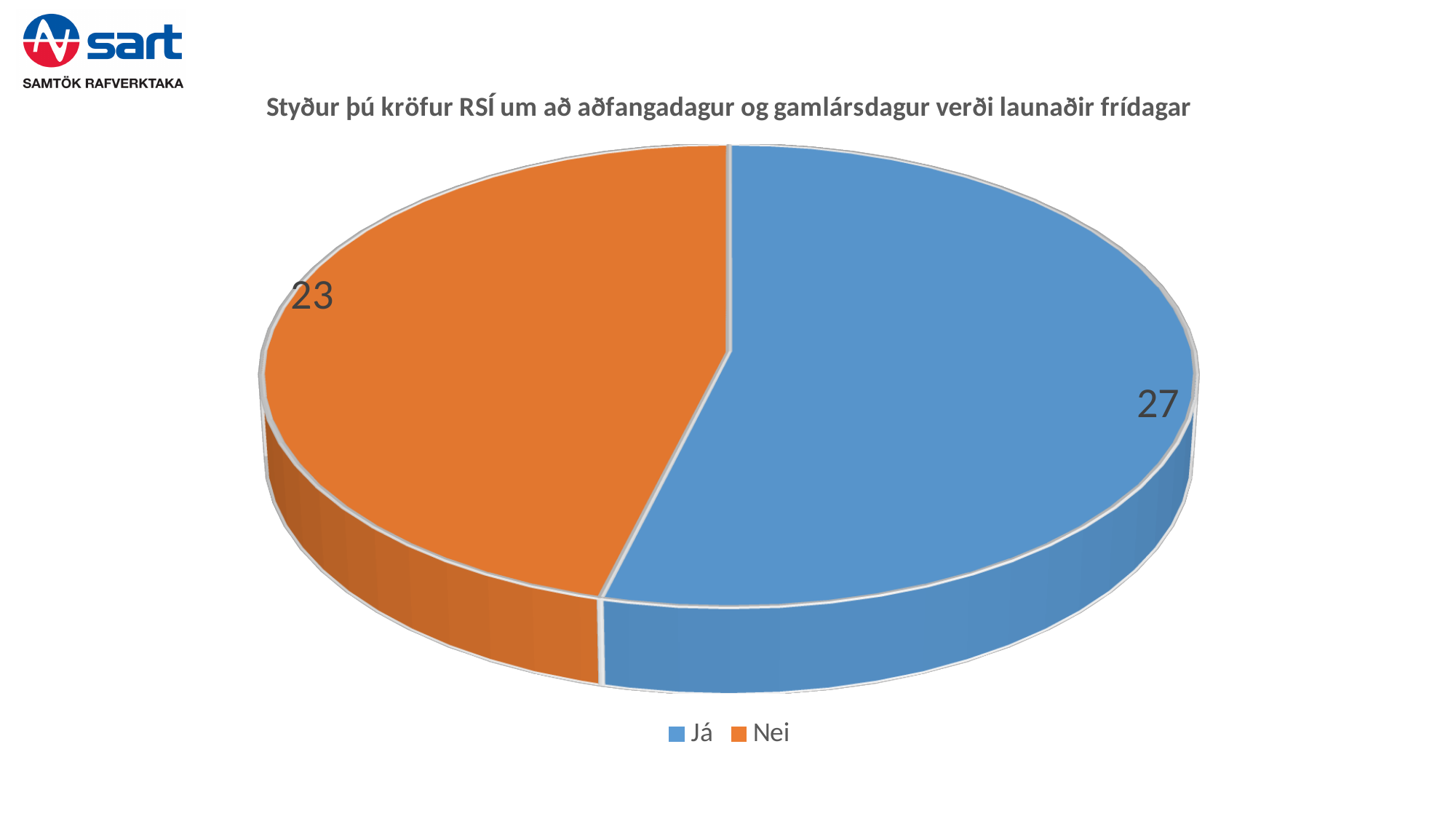
Which is larger, Já or Nei? Já What share of the pie does Já represent? 54% What is the title of the chart? Styður þú kröfur RSÍ um að aðfangadagur og gamlársdagur verði launaðir frídagar What colour is the Nei slice? Orange What is the value for Já? 27 What is the value for Nei? 23 What kind of chart is shown on the slide? Pie chart Which category has the largest slice? Já How many categories does the pie chart show? 2 What is the total of all slices in the pie chart? 50 Which category has the smallest slice? Nei What is the difference between the values for Já and Nei? 4